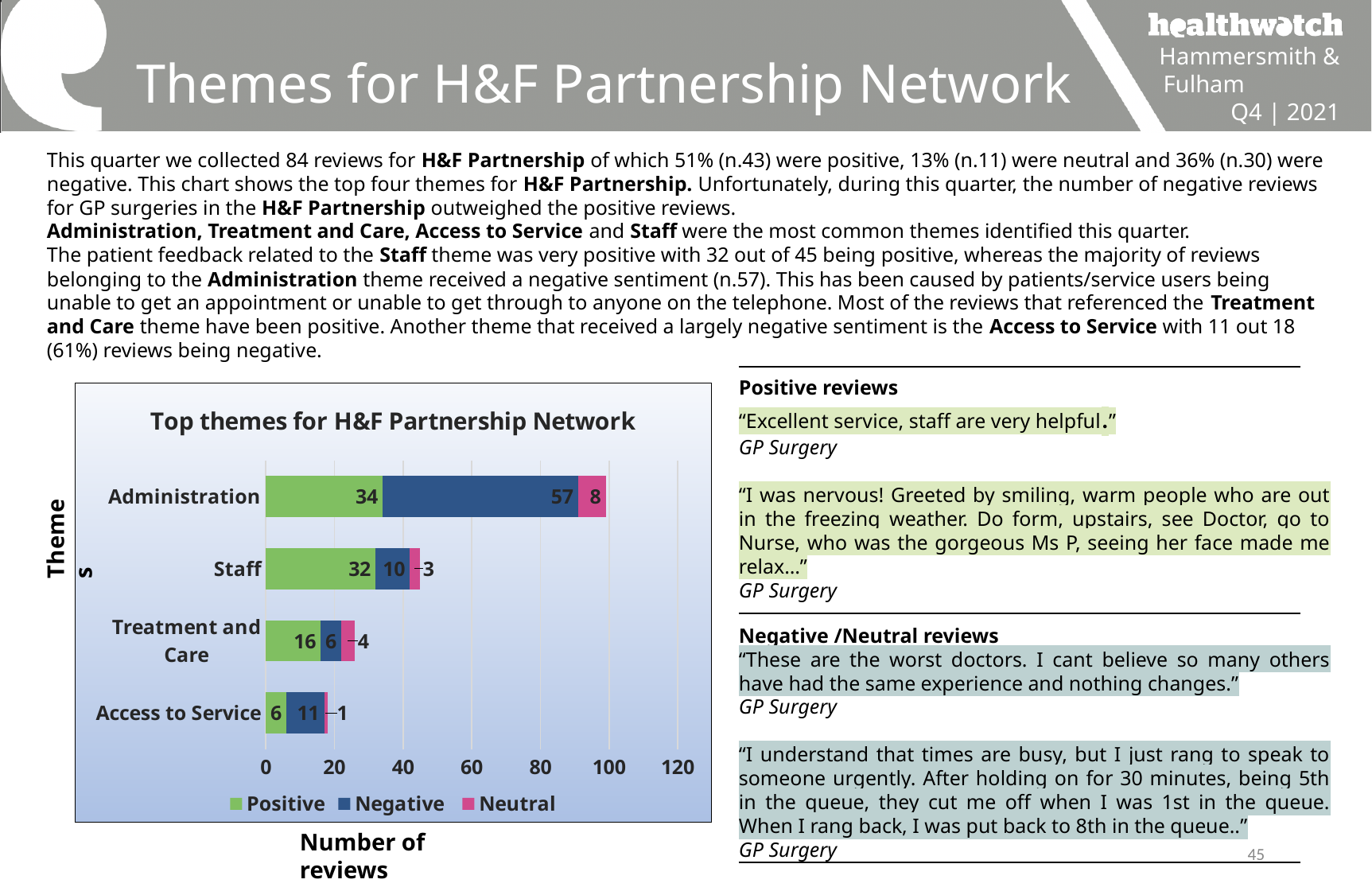
Which theme has the highest Positive value? Administration What is the total number of reviews in the Staff bar? 45 What is the difference between the Negative and Positive values for Administration? 23 What type of chart is shown on the slide? Stacked bar chart What is the Negative value for Administration? 57 What is the title of the chart? Top themes for H&F Partnership Network How many series does the chart legend list? 3 Which theme has the lowest Negative value? Treatment and Care Which is larger for Access to Service, the Positive value or the Negative value? Negative What is the Neutral value for Treatment and Care? 4 How many themes are plotted in the chart? 4 What is the Positive value for Staff? 32